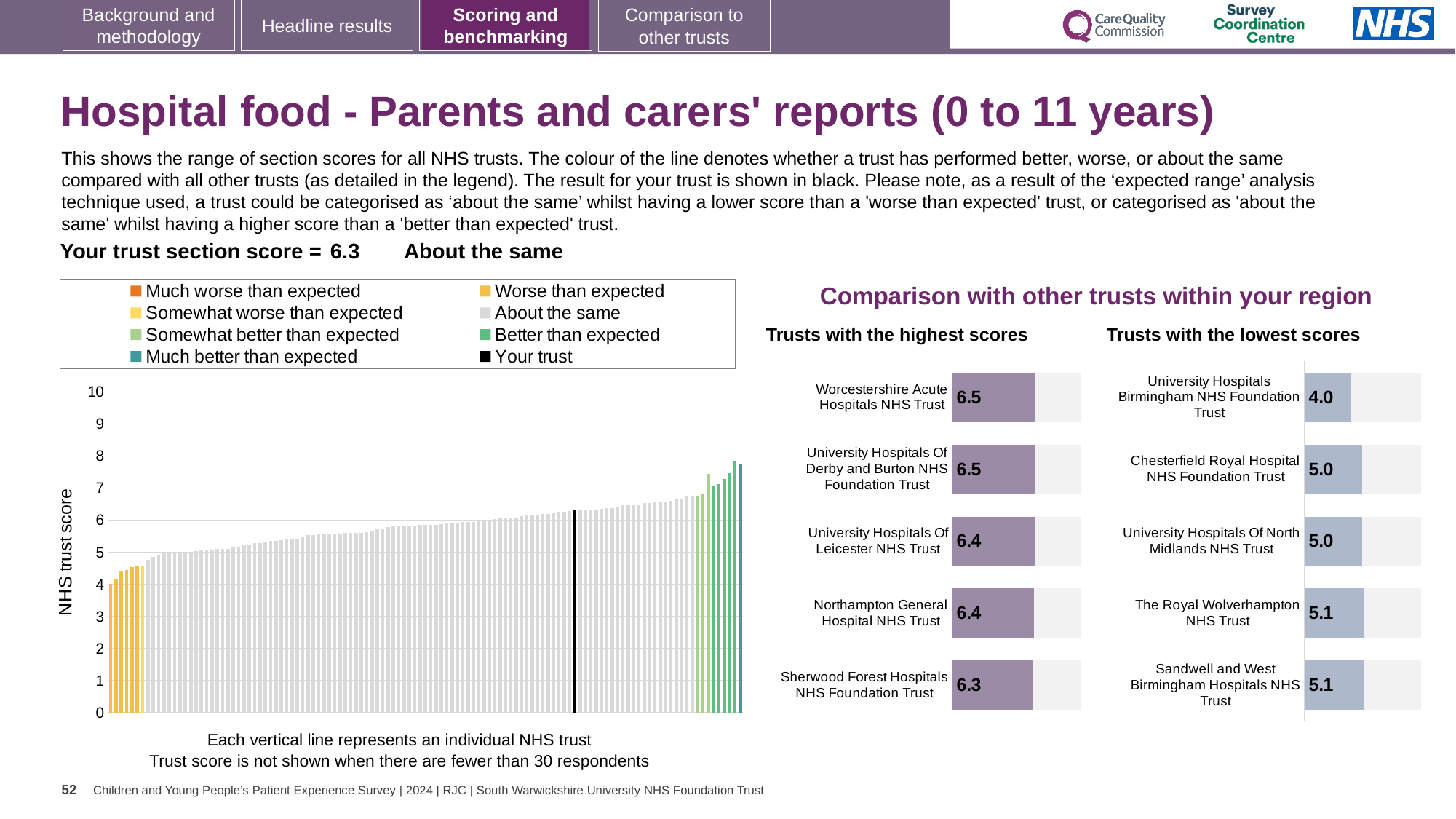
In the 'Trusts with the lowest scores' chart, what is the difference between the scores of Sandwell and West Birmingham Hospitals NHS Trust and University Hospitals Birmingham NHS Foundation Trust? 1.1 In the 'Trusts with the highest scores' chart, what is the score for Sherwood Forest Hospitals NHS Foundation Trust? 6.3 In the 'Trusts with the lowest scores' chart, what is the score for University Hospitals Birmingham NHS Foundation Trust? 4.0 In the 'Trusts with the highest scores' chart, what is the score for Worcestershire Acute Hospitals NHS Trust? 6.5 How many entries does the legend above the main chart on the left list? 8 How many trusts are listed in the 'Trusts with the lowest scores' chart? 5 What kind of chart is the main chart on the left with the 'NHS trust score' axis? bar chart In the 'Trusts with the highest scores' chart, what is the difference between the scores of Worcestershire Acute Hospitals NHS Trust and Sherwood Forest Hospitals NHS Foundation Trust? 0.2 In the 'Trusts with the highest scores' chart, which has the larger score: Worcestershire Acute Hospitals NHS Trust or Sherwood Forest Hospitals NHS Foundation Trust? Worcestershire Acute Hospitals NHS Trust In the main 'NHS trust score' chart on the left, do the bar values rise or fall from left to right? rise In the 'Trusts with the lowest scores' chart, which trust has the lowest score? University Hospitals Birmingham NHS Foundation Trust In the main 'NHS trust score' chart on the left, is the value for the black bar (your trust) greater or less than 6? greater